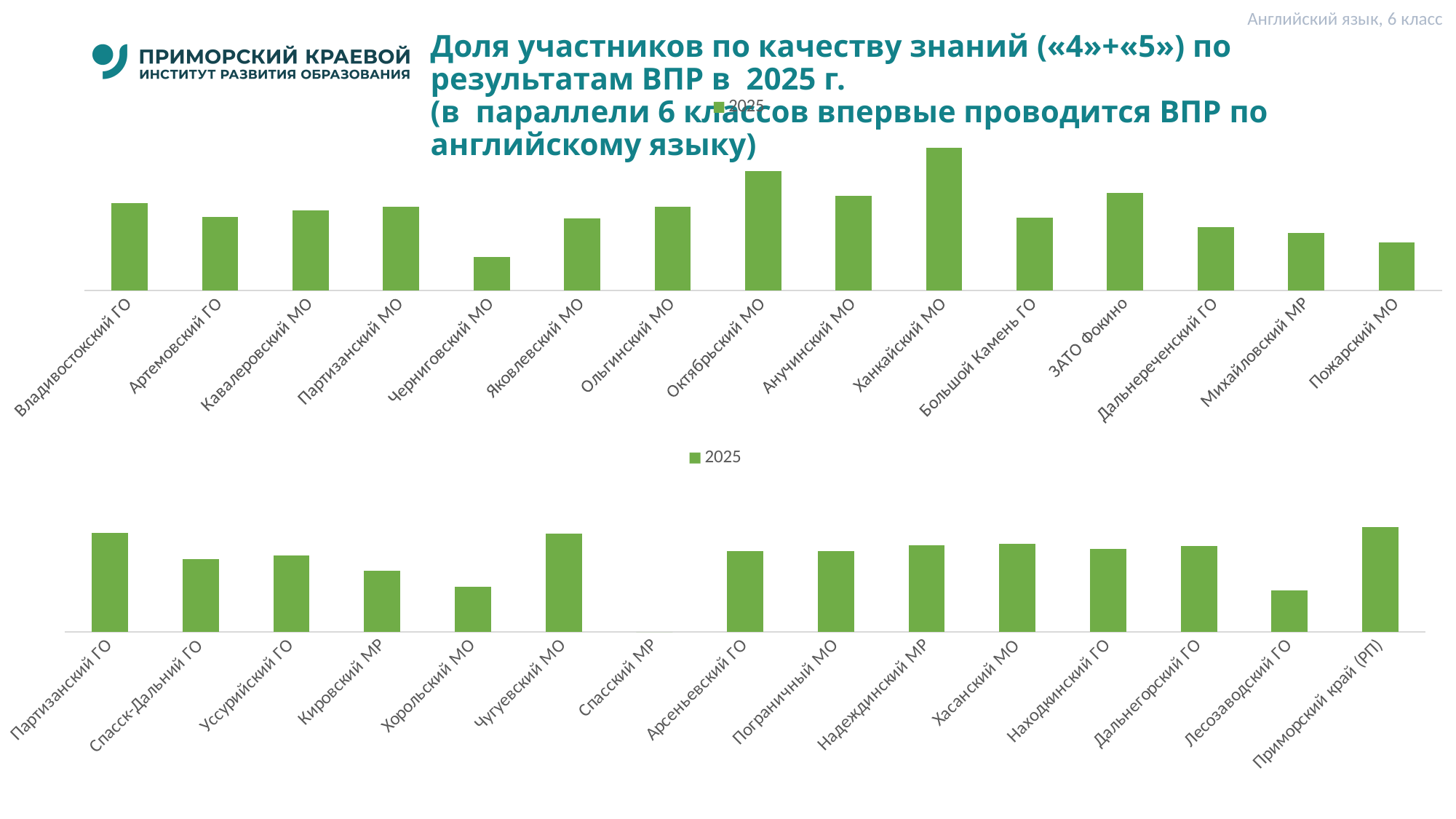
In the bottom chart, which category has the highest value? Приморский край (РП) In the top chart, which category has the highest value? Ханкайский МО What kind of chart is the top chart on the slide? bar chart What is the legend entry shown for the bottom chart? 2025 What kind of chart is the bottom chart on the slide? bar chart In the bottom chart, which is larger: the value for Чугуевский МО or the value for Кировский МР? Чугуевский МО In the top chart, which category has the lowest value? Черниговский МО In the top chart, which is larger: the value for Октябрьский МО or the value for Артемовский ГО? Октябрьский МО How many categories are shown on the x axis of the bottom chart? 15 How many series does the legend of the bottom chart list? 1 In the top chart, which is larger: the value for Ханкайский МО or the value for Пожарский МО? Ханкайский МО How many categories are shown on the x axis of the top chart? 15